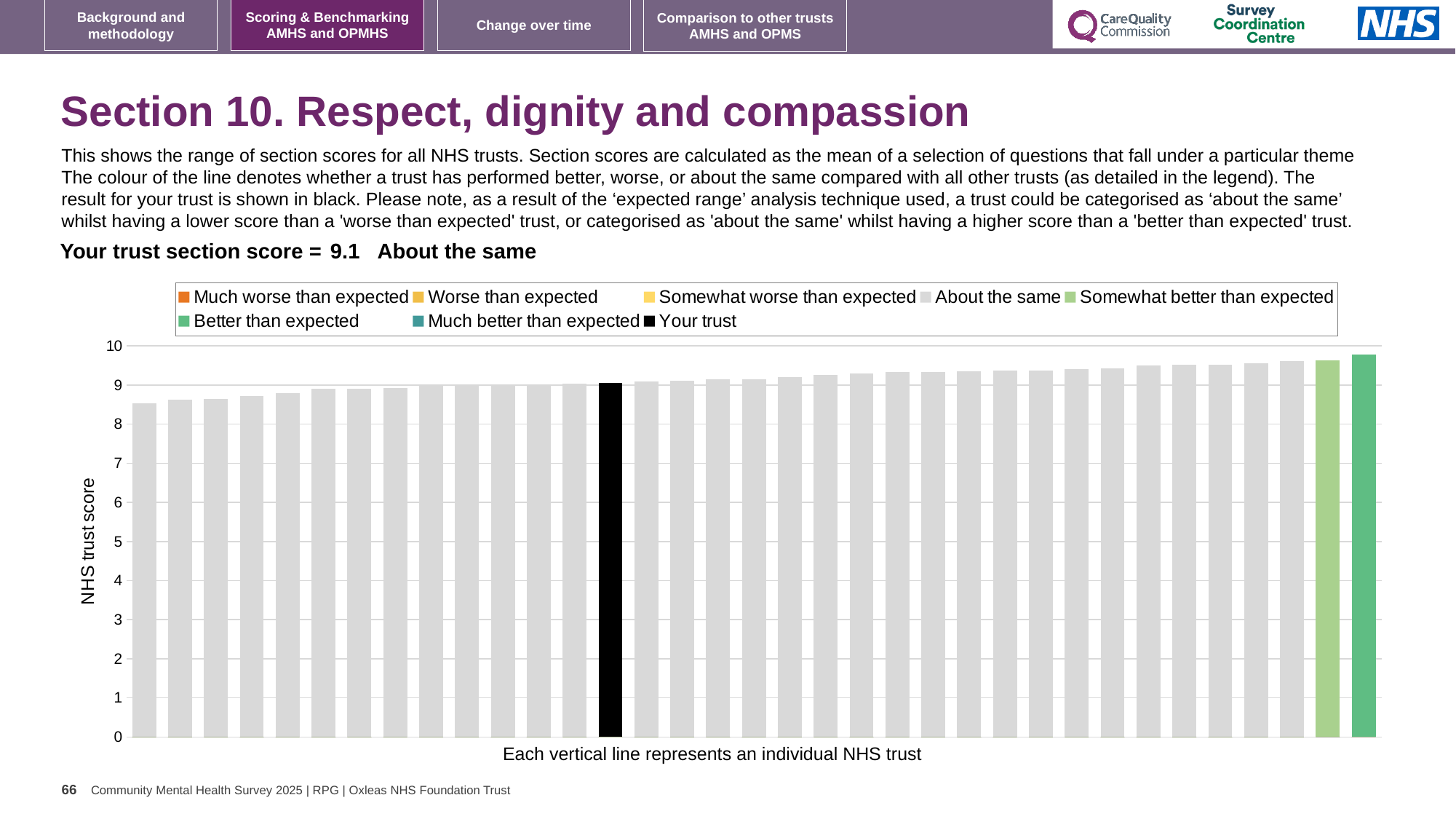
Is the value for your trust's bar greater or less than 5? greater What kind of chart is shown on the slide? bar chart Do the bar values rise or fall from left to right along the x axis? rise What is the label on the vertical axis of the chart? NHS trust score How many entries does the chart legend list? 8 What is the section score for your trust shown on the slide? 9.1 Which bar is larger, the leftmost bar or the rightmost bar? the rightmost bar What colour is the bar representing your trust? black How many bars (NHS trusts) are plotted in the chart? 35 Which performance category is your trust placed in for this section? About the same Is the value of the leftmost (lowest) bar greater or less than 8? greater Is the value of the rightmost bar greater or less than 9? greater